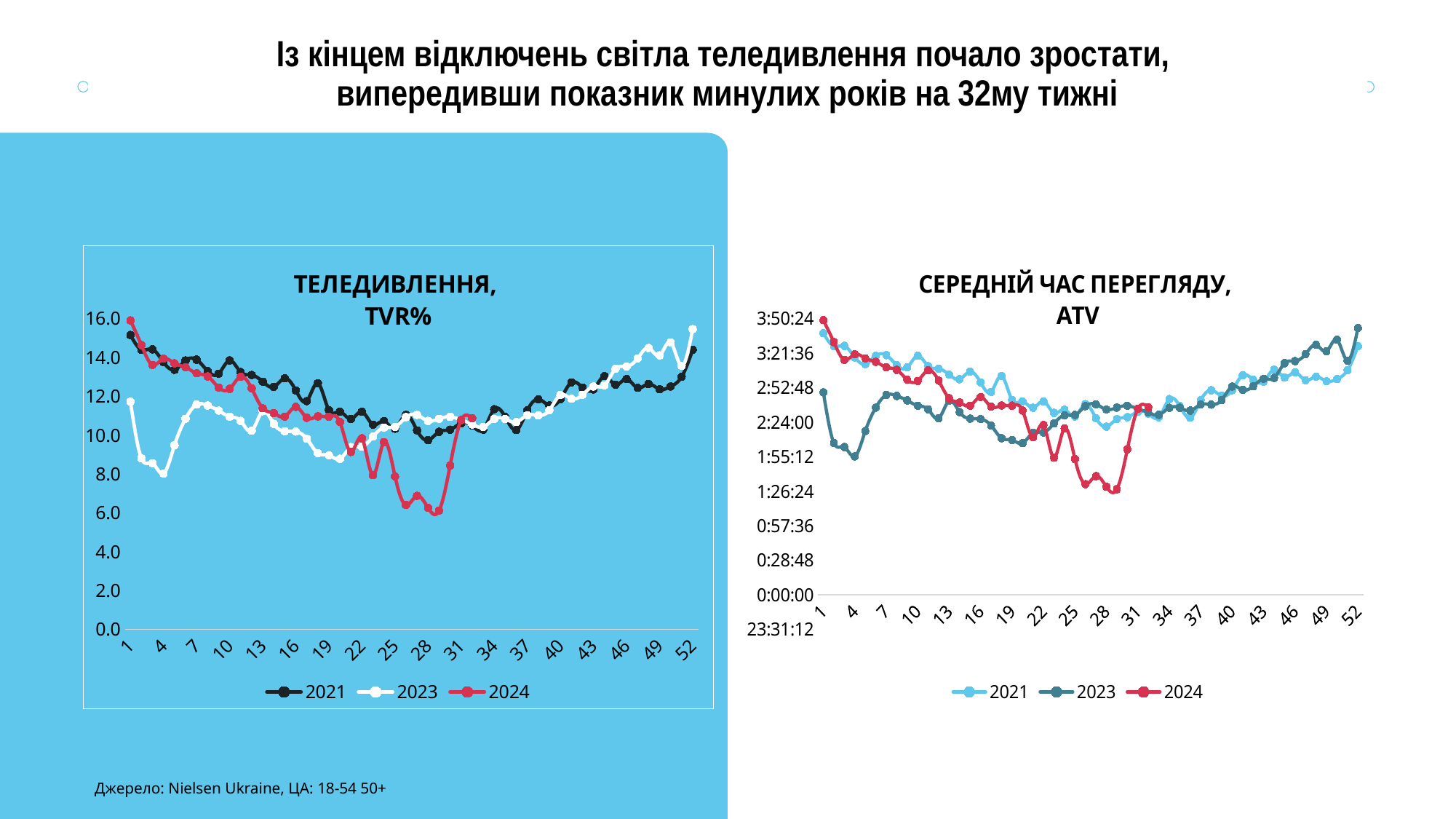
In the left chart "ТЕЛЕДИВЛЕННЯ, TVR%", is the 2023 value at week 52 greater or less than 14.0? greater What is the last week number shown on the x axis of the right chart "СЕРЕДНІЙ ЧАС ПЕРЕГЛЯДУ, ATV"? 52 In the left chart "ТЕЛЕДИВЛЕННЯ, TVR%", which series has the larger value at week 28, 2021 or 2024? 2021 In the right chart "СЕРЕДНІЙ ЧАС ПЕРЕГЛЯДУ, ATV", which series has the larger value at week 28, 2021 or 2024? 2021 In the left chart "ТЕЛЕДИВЛЕННЯ, TVR%", is the 2021 value at week 1 greater or less than 14.0? greater Which series are listed in the legend of the right chart "СЕРЕДНІЙ ЧАС ПЕРЕГЛЯДУ, ATV"? 2021, 2023, 2024 In the right chart "СЕРЕДНІЙ ЧАС ПЕРЕГЛЯДУ, ATV", is the 2024 value at week 1 greater or less than 3:21:36? greater How many series does the legend of the left chart "ТЕЛЕДИВЛЕННЯ, TVR%" list? 3 In the left chart "ТЕЛЕДИВЛЕННЯ, TVR%", does the 2021 series rise or fall from week 40 to week 52? rise What kind of chart is the left chart titled "ТЕЛЕДИВЛЕННЯ, TVR%"? line chart What kind of chart is the right chart titled "СЕРЕДНІЙ ЧАС ПЕРЕГЛЯДУ, ATV"? line chart